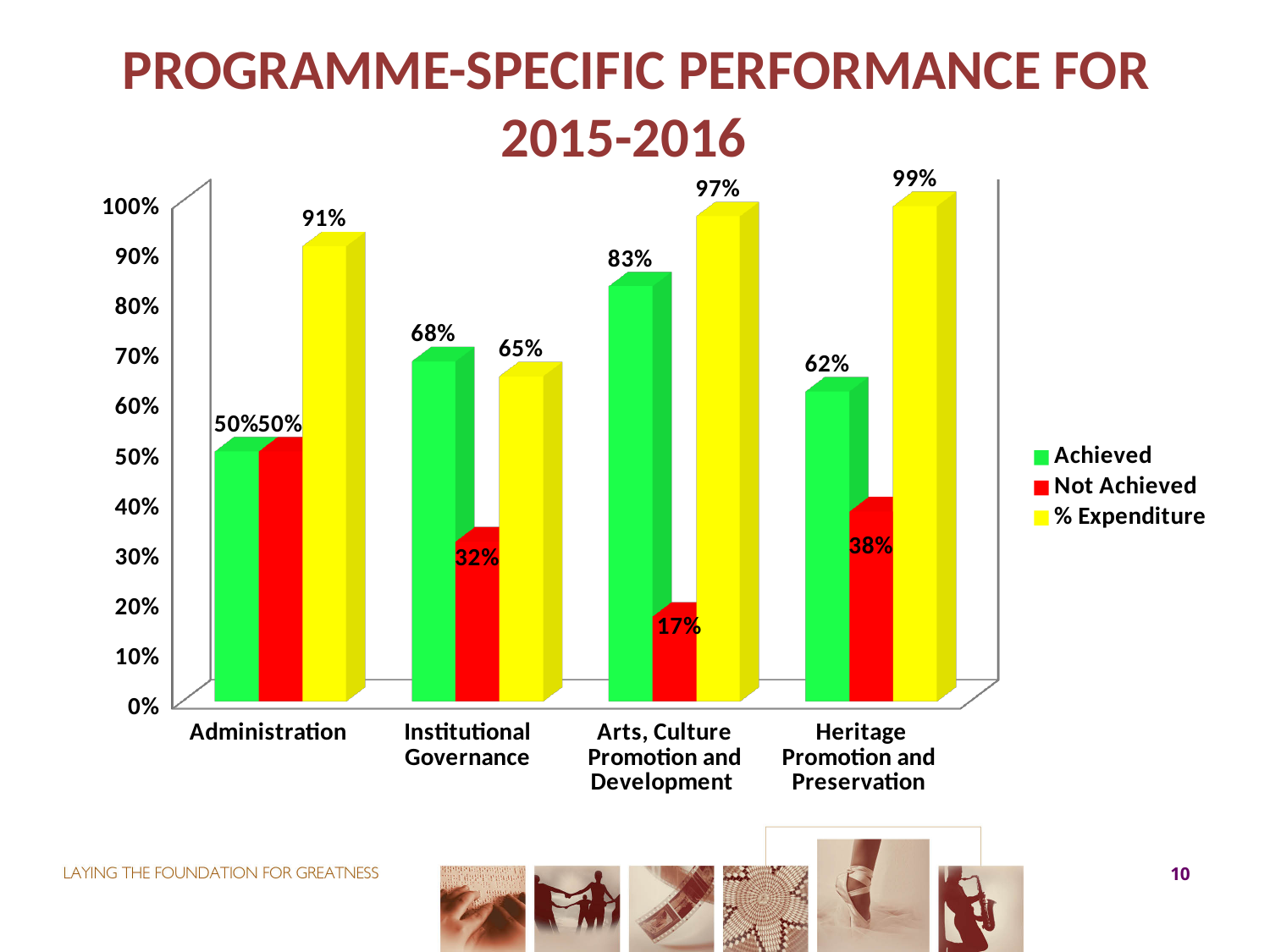
What is the Not Achieved value for Heritage Promotion and Preservation? 38% Does the % Expenditure value rise or fall from Institutional Governance to Arts, Culture Promotion and Development? Rise Which category has the lowest Not Achieved value? Arts, Culture Promotion and Development How many series does the legend list? 3 Which is larger for Institutional Governance: Achieved or % Expenditure? Achieved What is the difference between the Achieved and Not Achieved values for Institutional Governance? 36% Which category has the highest % Expenditure? Heritage Promotion and Preservation What kind of chart is shown on the slide? Bar chart What colour represents the Not Achieved series? Red What is the Achieved value for Arts, Culture Promotion and Development? 83% How many categories are shown on the x axis? 4 What is the % Expenditure value for Administration? 91%